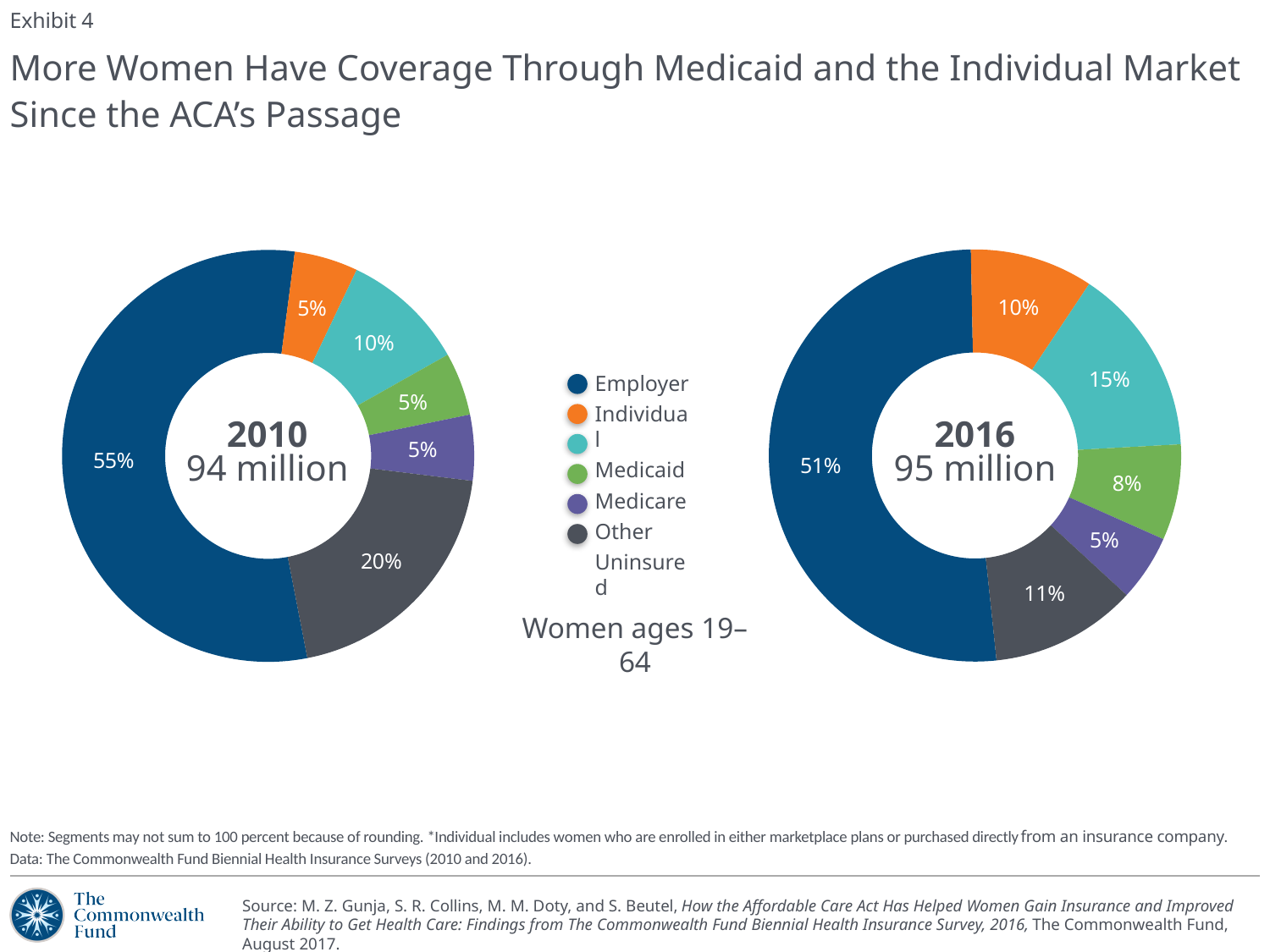
How many coverage categories does the legend list? 6 What total number of women does the 2016 chart represent, as shown in its center? 95 million Which is larger: the Individual share in the 2010 chart or the Individual share in the 2016 chart? 2016 In the 2010 chart, what share of women were uninsured? 20% In the 2016 chart, which coverage category has the smallest share? Other What type of charts are shown on the slide? Pie (donut) charts In the 2016 chart, what share of women had Medicaid coverage? 15% By how many percentage points did the uninsured share fall from the 2010 chart to the 2016 chart? 9 percentage points In the 2016 chart, what share of women had coverage through an employer? 51% In the 2010 chart, what share of women had coverage through an employer? 55% In the 2016 chart, what share of women were uninsured? 11% In the 2010 chart, which coverage category has the largest share? Employer